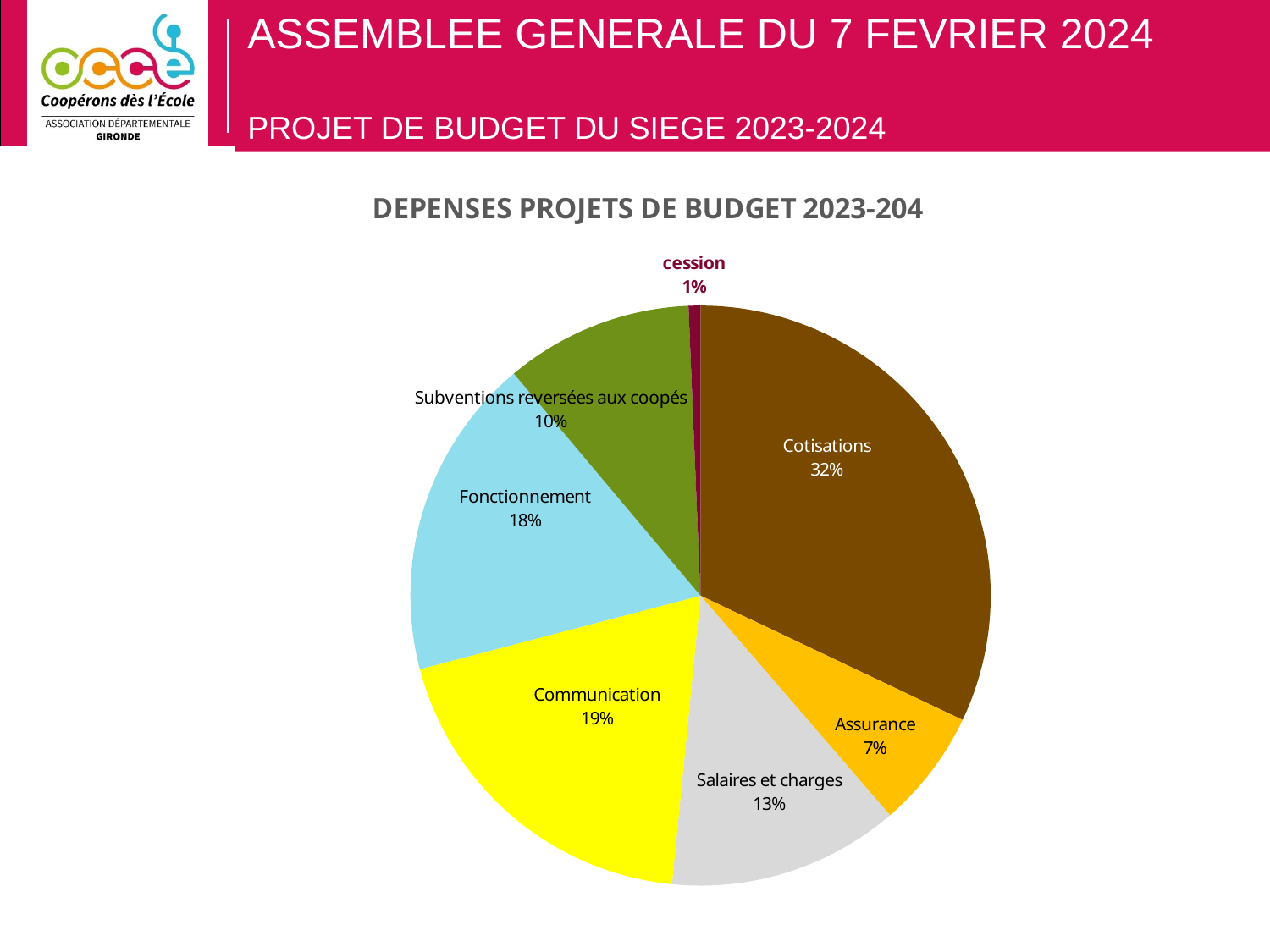
What is the value shown for Salaires et charges? 13% What kind of chart is shown on the slide? pie chart Which category has the smallest slice of the pie? cession How many slices does the pie chart have? 7 What is the value shown for Communication? 19% Which category has the largest slice of the pie? Cotisations What is the value shown for Subventions reversées aux coopés? 10% What is the value shown for Fonctionnement? 18% What is the title of the chart? DEPENSES PROJETS DE BUDGET 2023-204 What share of the pie does Cotisations represent? 32% Which is larger, the share for Communication or the share for Salaires et charges? Communication What is the difference between the shares of Cotisations and Assurance? 25%